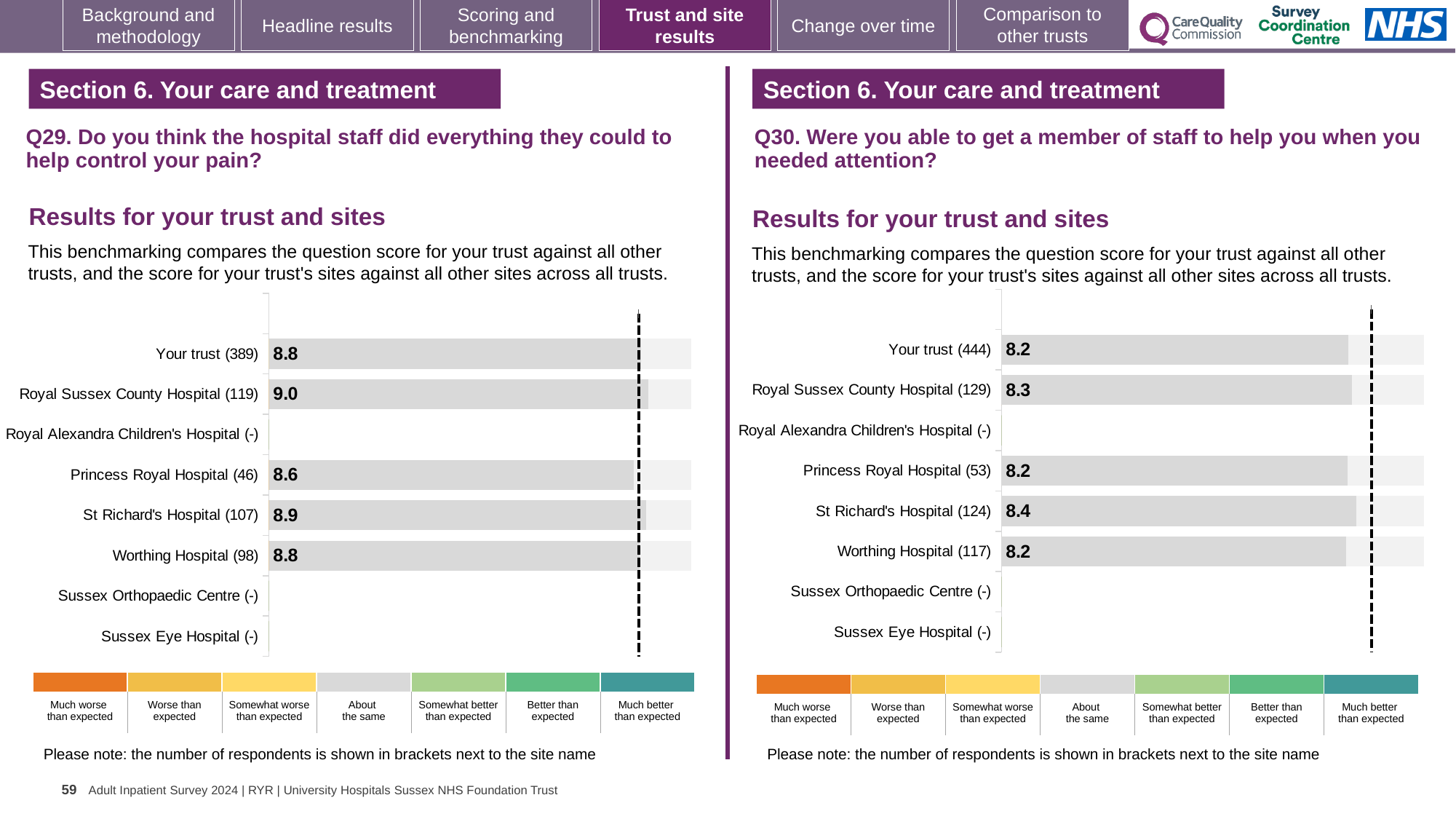
In the Q30 chart on the right, how many respondents are shown for Your trust? 444 How many site or trust labels are listed on the y axis of the Q29 chart on the left? 8 In the Q30 chart on the right, what is the score for Your trust? 8.2 In the Q29 chart on the left, what is the score for Royal Sussex County Hospital? 9.0 What type of chart is used for the Q29 results on the left? Bar chart In the Q30 chart on the right, which site has the highest score? St Richard's Hospital In the Q29 chart on the left, which site has the highest score? Royal Sussex County Hospital In the Q30 chart on the right, which is larger: the score for Royal Sussex County Hospital or the score for Worthing Hospital? Royal Sussex County Hospital In the Q29 chart on the left, what is the score for Princess Royal Hospital? 8.6 In the Q29 chart on the left, which site with a score shown has the lowest score? Princess Royal Hospital In the Q30 chart on the right, what is the score for St Richard's Hospital? 8.4 In the Q29 chart on the left, what is the difference between the scores for St Richard's Hospital and Princess Royal Hospital? 0.3